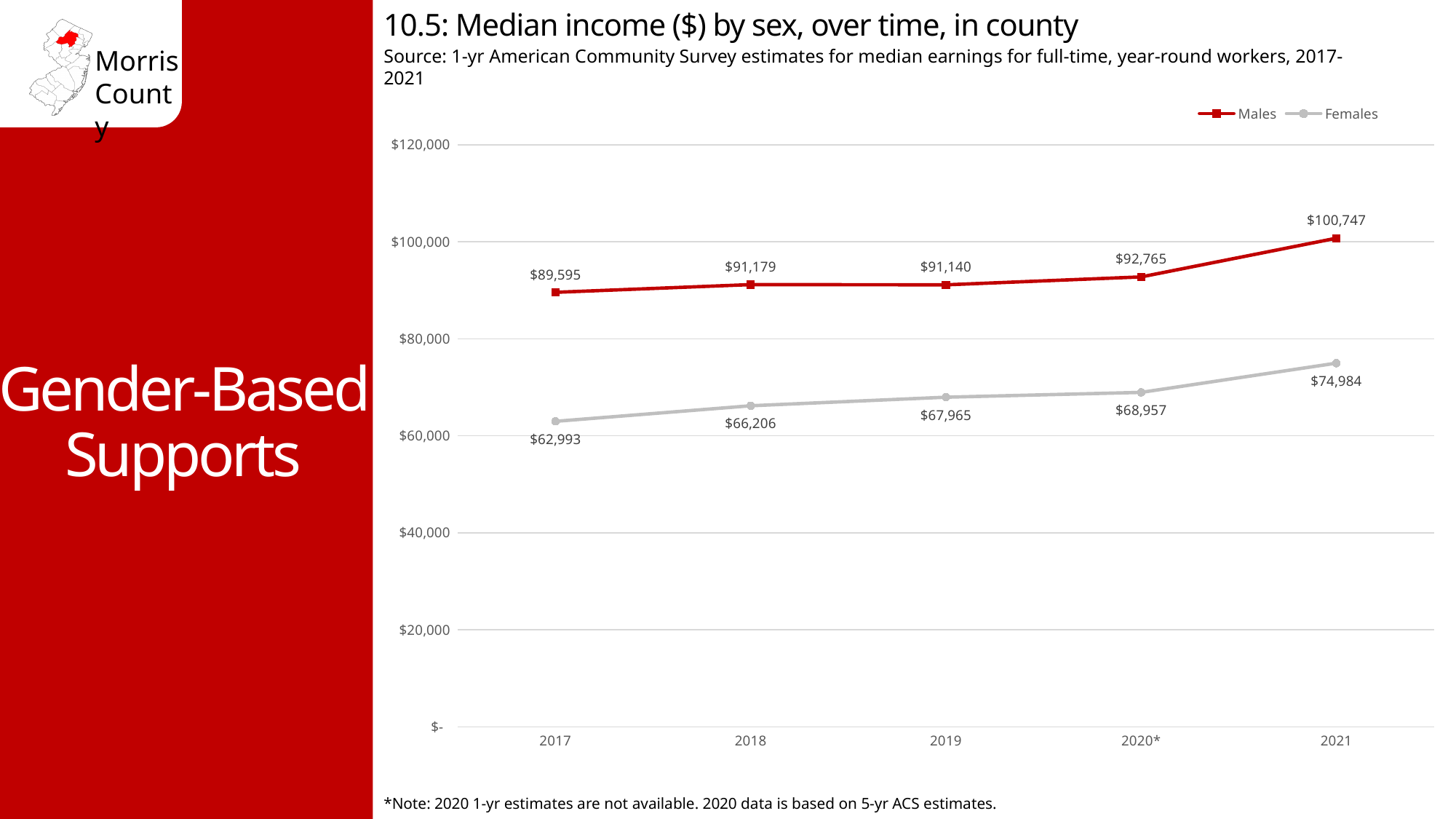
What was the median income for males in 2019? $91,140 What is the difference between male and female median income in 2021? $25,763 What was the median income for females in 2017? $62,993 In which year was the median income for males highest? 2021 How many series does the legend list? 2 What is the difference between male and female median income in 2017? $26,602 What was the median income for males in 2021? $100,747 In which year was the median income for females lowest? 2017 What was the median income for females in 2020*? $68,957 Which was higher in 2018, the median income for males or for females? Males What kind of chart is shown on the slide? Line chart How many years are shown on the x axis? 5